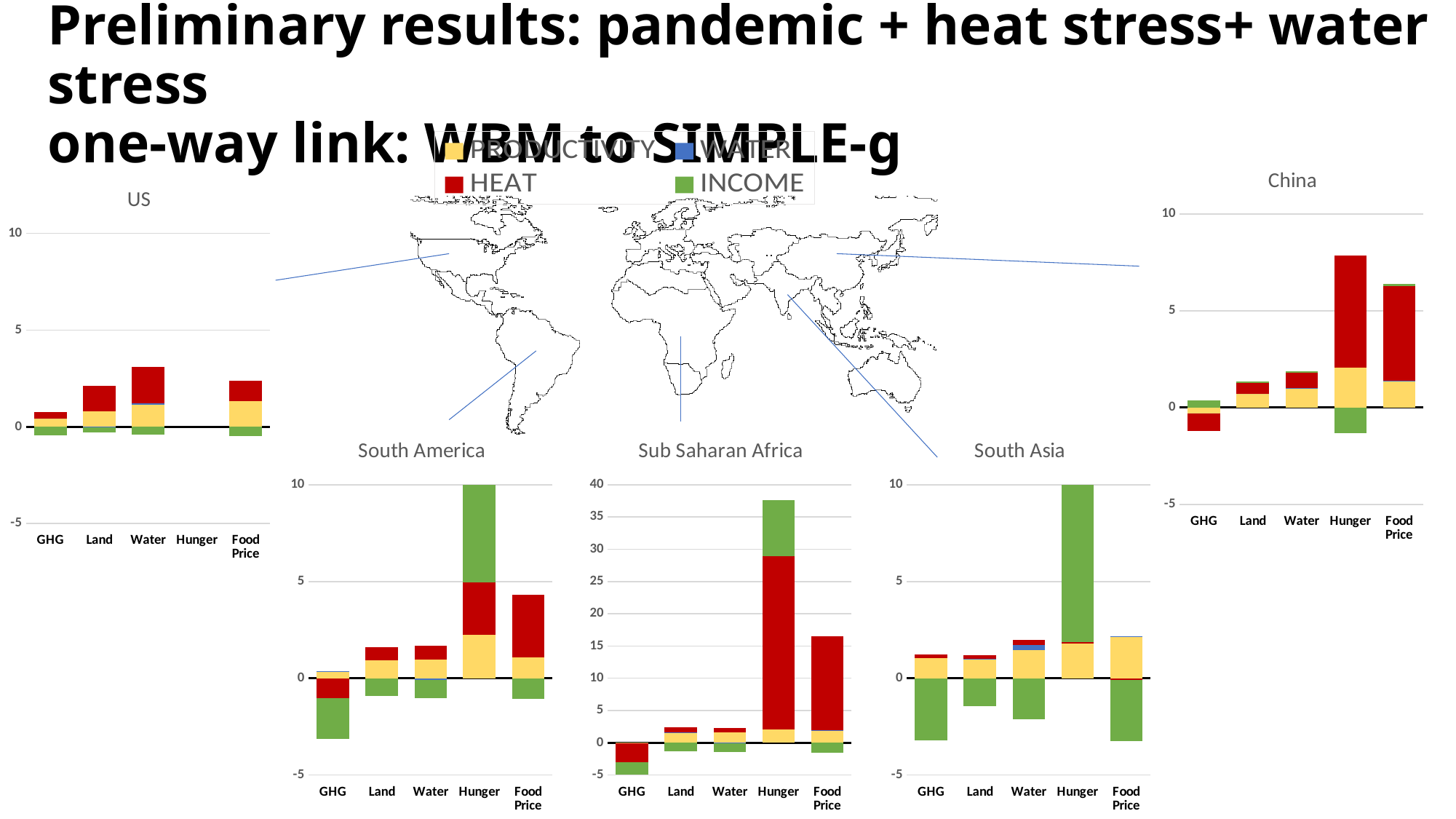
In the China chart, which category has the tallest bar? Hunger In the Sub Saharan Africa chart, is the top of the Hunger bar greater or less than 30? greater In the South America chart, is the top of the Food Price bar greater or less than 5? less In the South America chart, which bar is taller: Hunger or Food Price? Hunger How many regional bar charts are shown on the slide? 5 Which colour represents HEAT in the legend? red In the Sub Saharan Africa chart, which category has the tallest bar? Hunger What kind of chart is the US chart? stacked bar chart In the China chart, is the top of the Hunger bar greater or less than 5? greater How many categories are shown on the x axis of the Sub Saharan Africa chart? 5 How many series does the legend list? 4